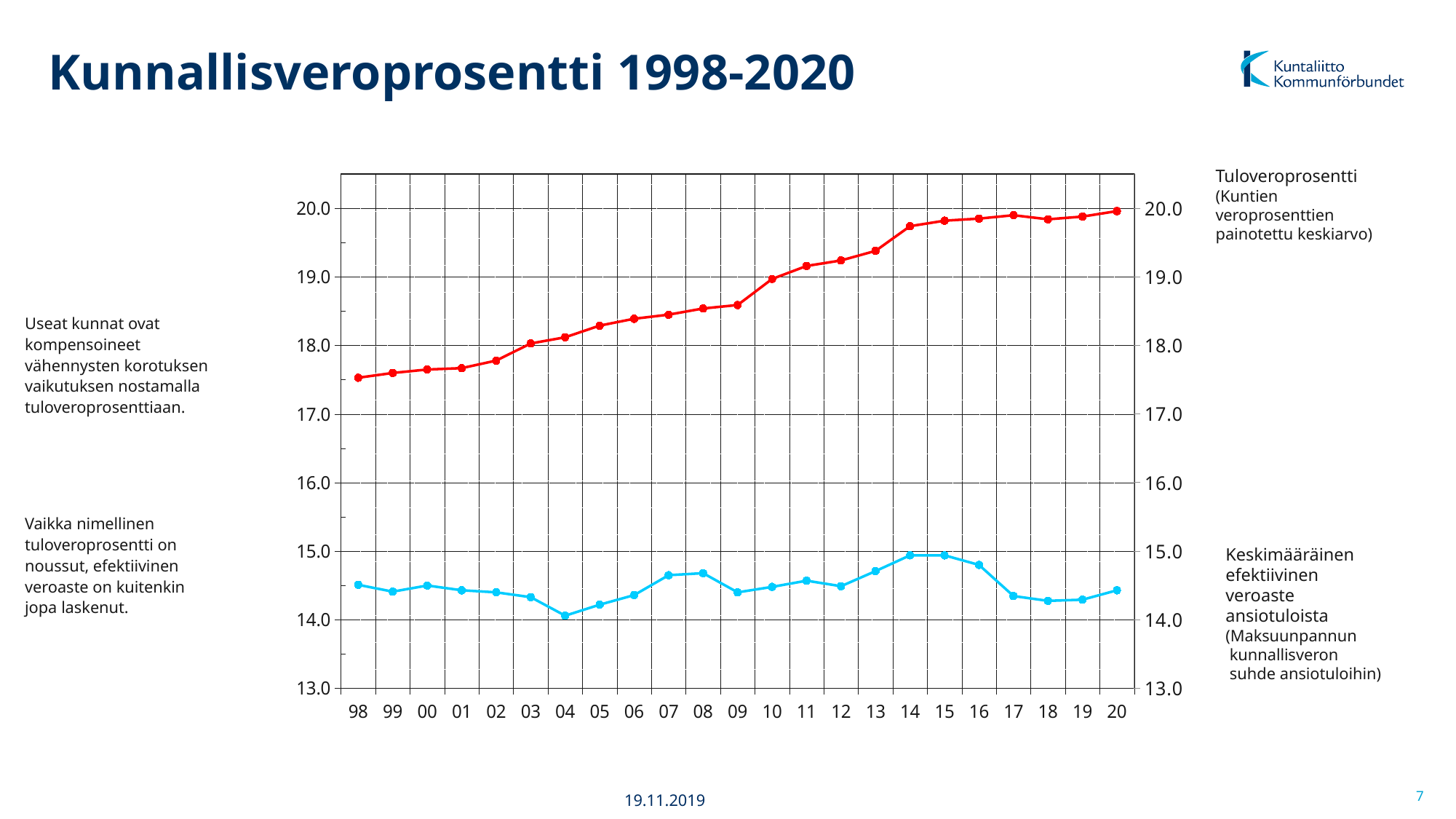
How many years (data points per series) are plotted along the x axis? 23 Is the Tuloveroprosentti value for 98 greater or less than 18.0? less Is the Tuloveroprosentti value for 13 greater or less than 19.0? greater What kind of chart is shown on the slide? Line chart What colour is the Tuloveroprosentti line? Red In which year is the Keskimääräinen efektiivinen veroaste (blue) line at its lowest? 04 Which is larger in 10: the Tuloveroprosentti value or the Keskimääräinen efektiivinen veroaste value? Tuloveroprosentti Does the Tuloveroprosentti (red) line rise or fall from 98 to 20? Rises Is the Keskimääräinen efektiivinen veroaste value for 07 greater or less than 15.0? less How many data series are plotted on the chart? 2 In which year is the Tuloveroprosentti (red) line at its lowest? 98